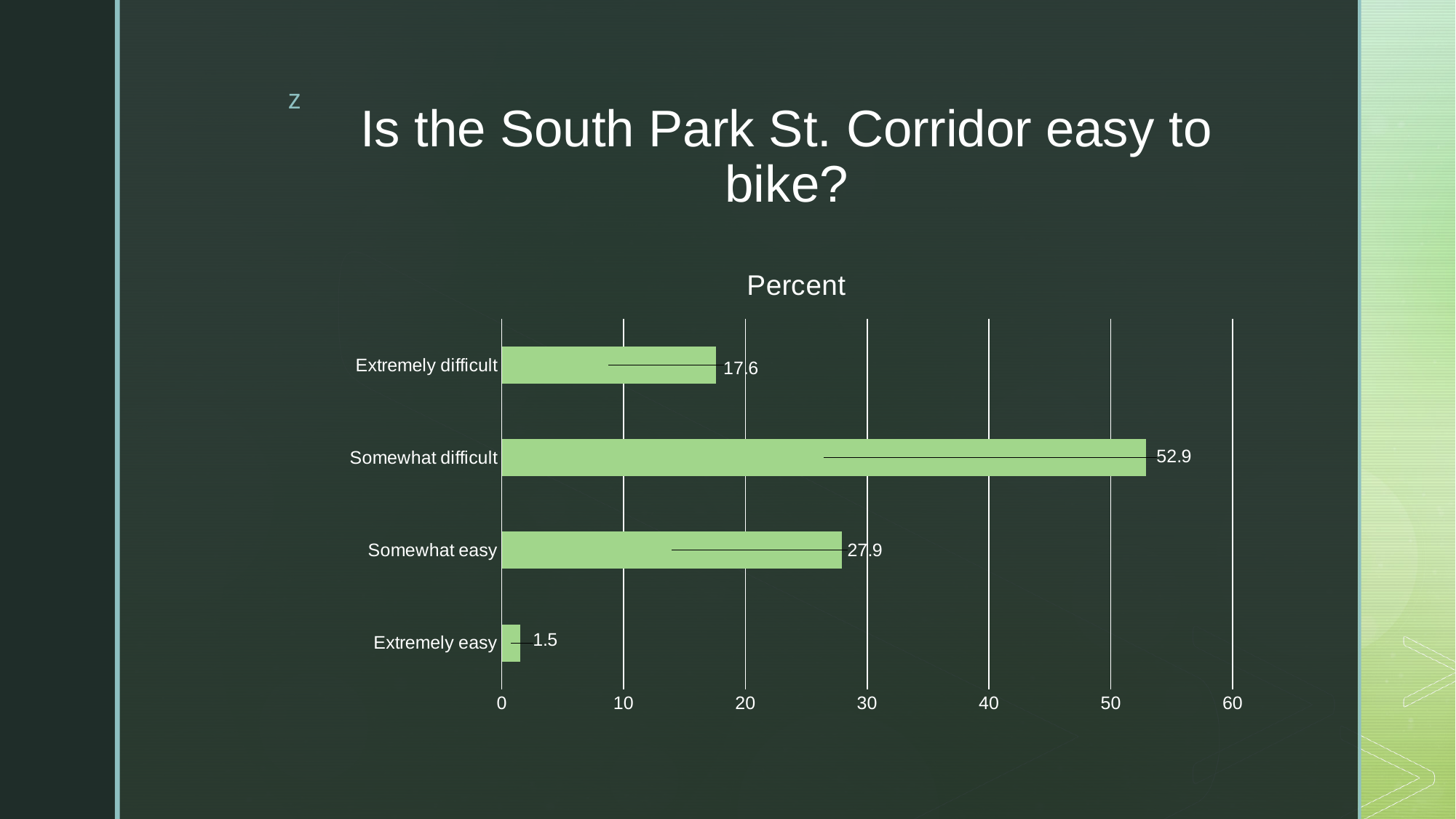
Which category has the lowest value? Extremely easy How many categories are shown in the chart? 4 What is the difference between the values for Somewhat difficult and Somewhat easy? 25 Which is larger, the value for Somewhat easy or the value for Extremely difficult? Somewhat easy What is the value for Extremely easy? 1.5 What is the value for Somewhat easy? 27.9 Is the value for Somewhat difficult greater or less than 50? greater What is the title of the chart? Percent What kind of chart is shown on the slide? bar chart What is the value for Extremely difficult? 17.6 What is the value for Somewhat difficult? 52.9 Which category has the highest value? Somewhat difficult